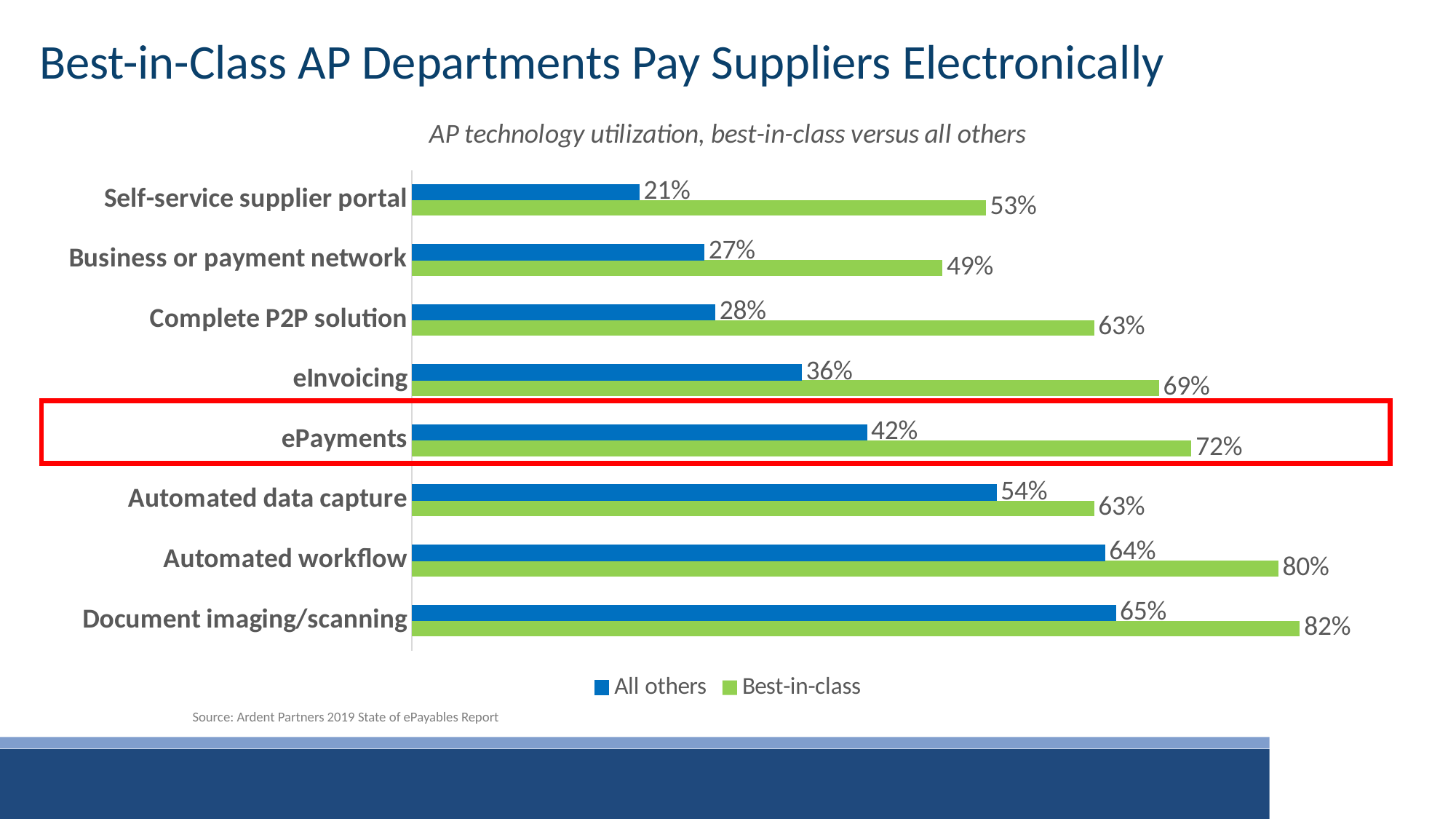
What is the Best-in-class value for ePayments? 72% Which category is highlighted with a red box on the chart? ePayments How many series does the legend list? 2 What is the difference between the Best-in-class and All others values for ePayments? 30% What is the Best-in-class value for Complete P2P solution? 63% How many categories are shown on the chart? 8 Which is larger: the All others value for Automated data capture or the All others value for eInvoicing? Automated data capture Which category has the highest Best-in-class value? Document imaging/scanning What is the difference between the Best-in-class and All others values for Complete P2P solution? 35% Which category has the lowest All others value? Self-service supplier portal What is the All others value for Self-service supplier portal? 21% What kind of chart is shown on the slide? Bar chart